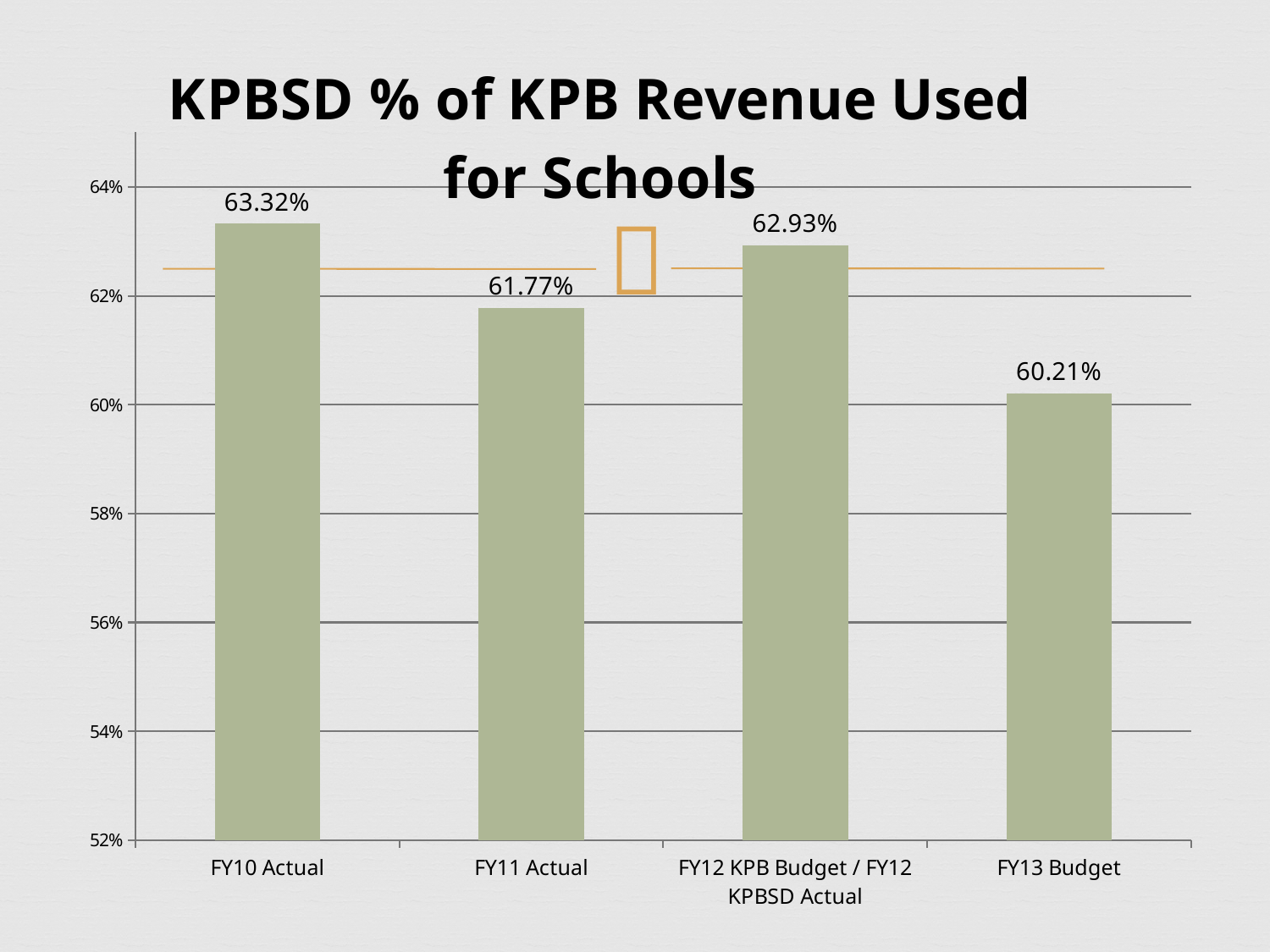
What is the value for FY13 Budget? 60.21% How many categories are shown on the x axis? 4 What is the value for FY11 Actual? 61.77% What is the title of the chart? KPBSD % of KPB Revenue Used for Schools Is the value for FY13 Budget greater or less than 62%? less Which is larger, the value for FY11 Actual or the value for FY12 KPB Budget / FY12 KPBSD Actual? FY12 KPB Budget / FY12 KPBSD Actual Which category has the lowest value? FY13 Budget What kind of chart is shown on the slide? bar chart Which category has the highest value? FY10 Actual What is the value for FY12 KPB Budget / FY12 KPBSD Actual? 62.93% What is the value for FY10 Actual? 63.32% What is the difference between the FY10 Actual and FY13 Budget values? 3.11%